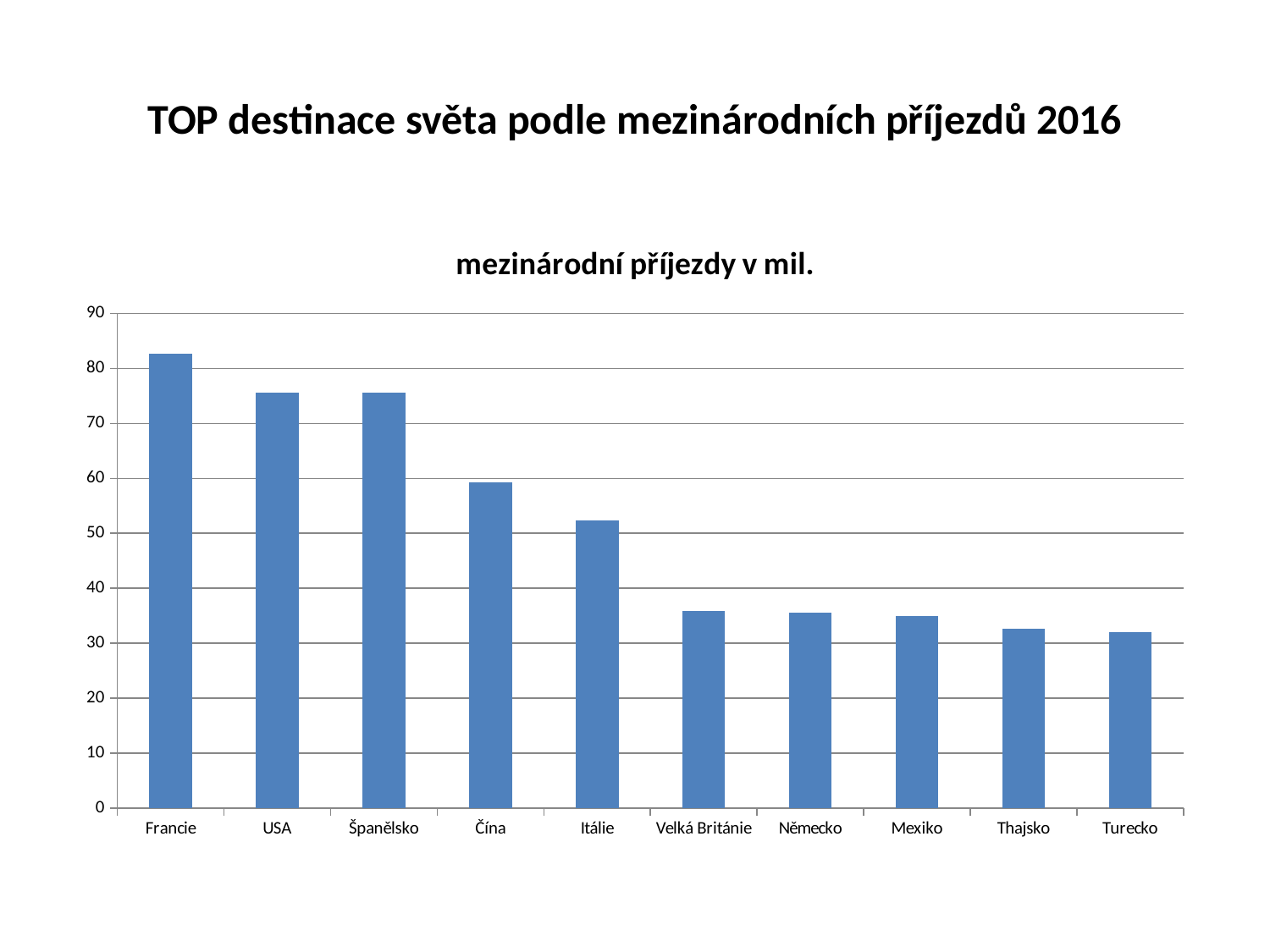
Which destination has the highest value in the chart? Francie What kind of chart is shown on the slide? bar chart What is the title of the chart? mezinárodní příjezdy v mil. Do the values rise or fall from left to right along the x axis? fall Is the value for Velká Británie greater or less than 40? less Which has a larger value, Čína or Itálie? Čína Is the value for USA greater or less than 70? greater Is the value for Turecko greater or less than 30? greater How many destinations are shown on the x axis of the chart? 10